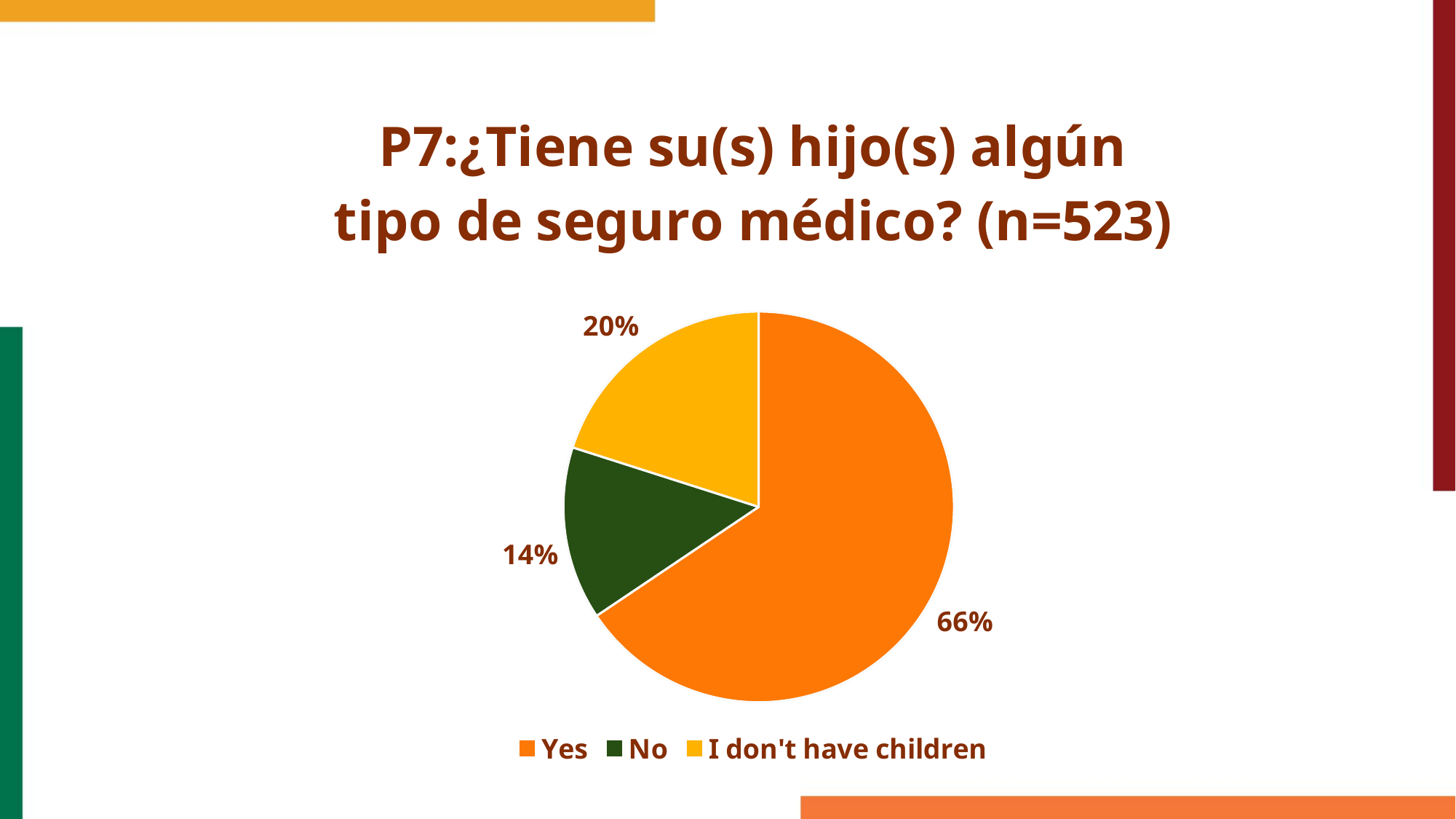
What kind of chart is shown on the slide? Pie chart How many slices does the pie chart have? 3 Which response has the smallest share of the pie? No Which is larger, the share for "No" or the share for "I don't have children"? I don't have children What is the difference in percentage points between "Yes" and "No"? 52 What percentage of respondents answered "No"? 14% What percentage of respondents answered "I don't have children"? 20% How many entries does the legend list? 3 What is the sample size (n) stated in the chart title? 523 What is the difference in percentage points between "I don't have children" and "No"? 6 Which response has the largest share of the pie? Yes What percentage of respondents answered "Yes"? 66%